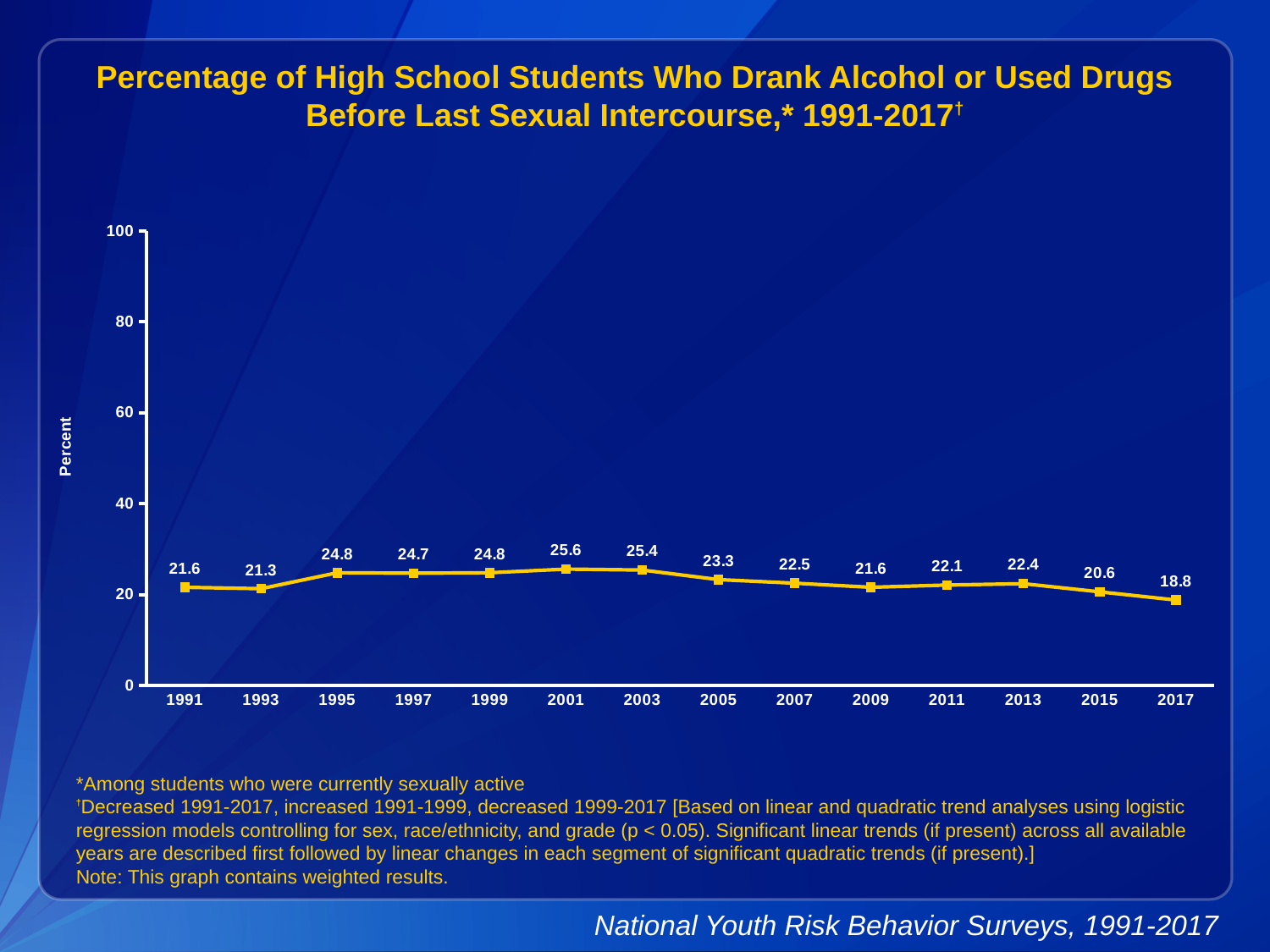
Which is larger, the value for 1995 or the value for 2009? 1995 What is the value for 1991? 21.6 What kind of chart is shown? line chart Which year has the lowest value? 2017 What is the label on the y axis? Percent Is the value for 2003 greater or less than 40? less What is the difference between the values for 1991 and 2017? 2.8 What is the value for 2001? 25.6 Do the values rise or fall from 2003 to 2017? fall Which year has the highest value? 2001 What is the value for 2017? 18.8 How many years are plotted on the chart? 14